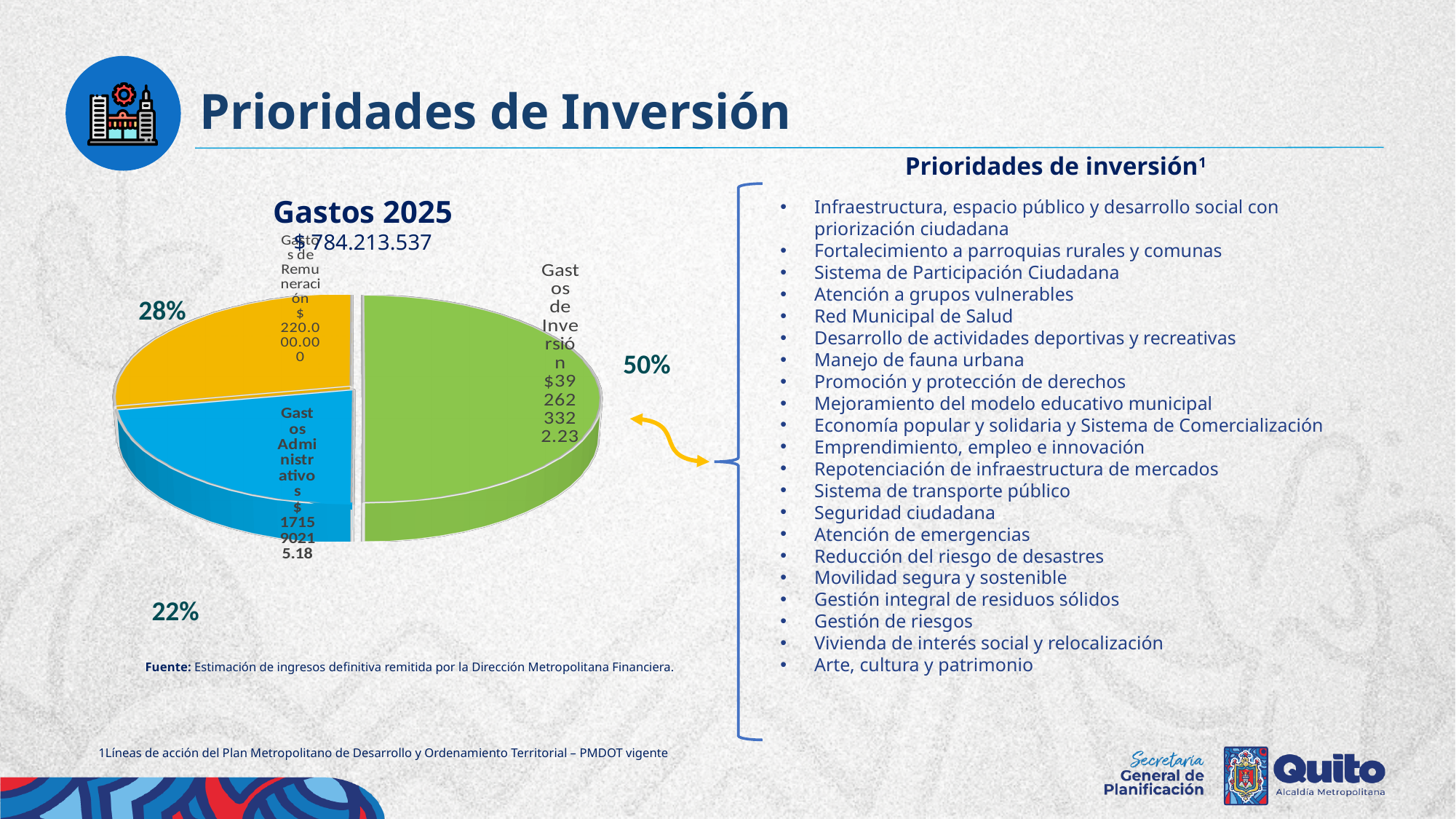
What share of the "Gastos 2025" pie does Gastos de Remuneración represent? 28% What share of the "Gastos 2025" pie does Gastos de Inversión represent? 50% Which category has the largest slice in the "Gastos 2025" pie chart? Gastos de Inversión What kind of chart is shown under the title "Gastos 2025"? pie chart What colour is the Gastos de Inversión slice in the "Gastos 2025" pie chart? green In the "Gastos 2025" pie chart, by how many percentage points does the share of Gastos de Remuneración exceed that of Gastos Administrativos? 6 percentage points What share of the "Gastos 2025" pie does Gastos Administrativos represent? 22% In the "Gastos 2025" pie chart, which is larger: Gastos de Remuneración or Gastos Administrativos? Gastos de Remuneración In the "Gastos 2025" pie chart, by how many percentage points does the share of Gastos de Inversión exceed that of Gastos de Remuneración? 22 percentage points How many slices does the "Gastos 2025" pie chart have? 3 Which category has the smallest slice in the "Gastos 2025" pie chart? Gastos Administrativos What total amount is printed beneath the "Gastos 2025" chart title? $784.213.537